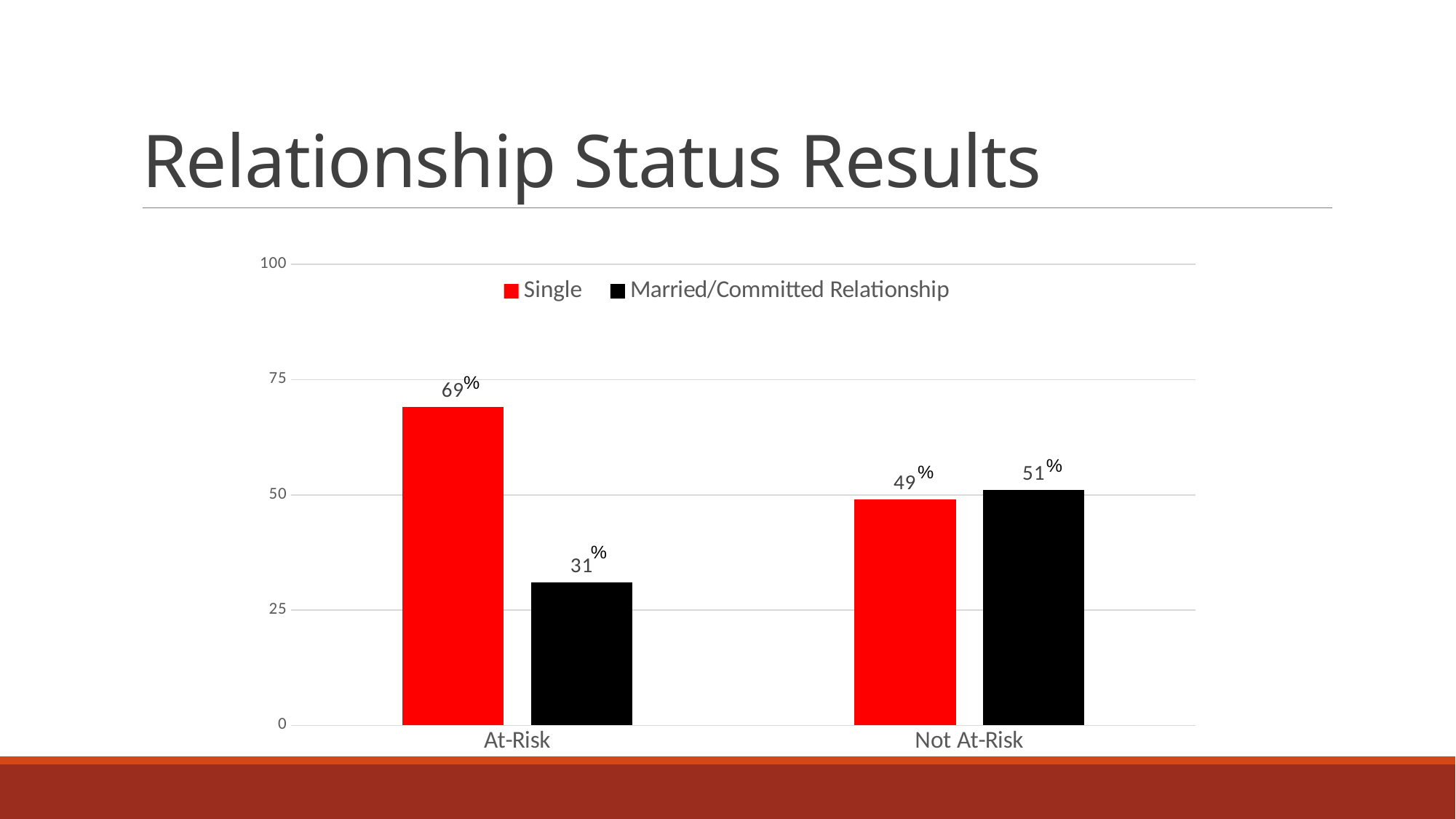
What is the difference between the Single and Married/Committed Relationship values in the At-Risk category? 38% In the At-Risk category, which is larger: Single or Married/Committed Relationship? Single What is the value for Married/Committed Relationship in the At-Risk category? 31% Which bar has the highest value on the chart? Single, At-Risk What is the value for Married/Committed Relationship in the Not At-Risk category? 51% What is the value for Single in the At-Risk category? 69% What colour represents the Single series? Red How many series does the legend list? 2 Which bar has the lowest value on the chart? Married/Committed Relationship, At-Risk How many categories are shown on the x axis? 2 What kind of chart is shown on the slide? Bar chart What is the value for Single in the Not At-Risk category? 49%